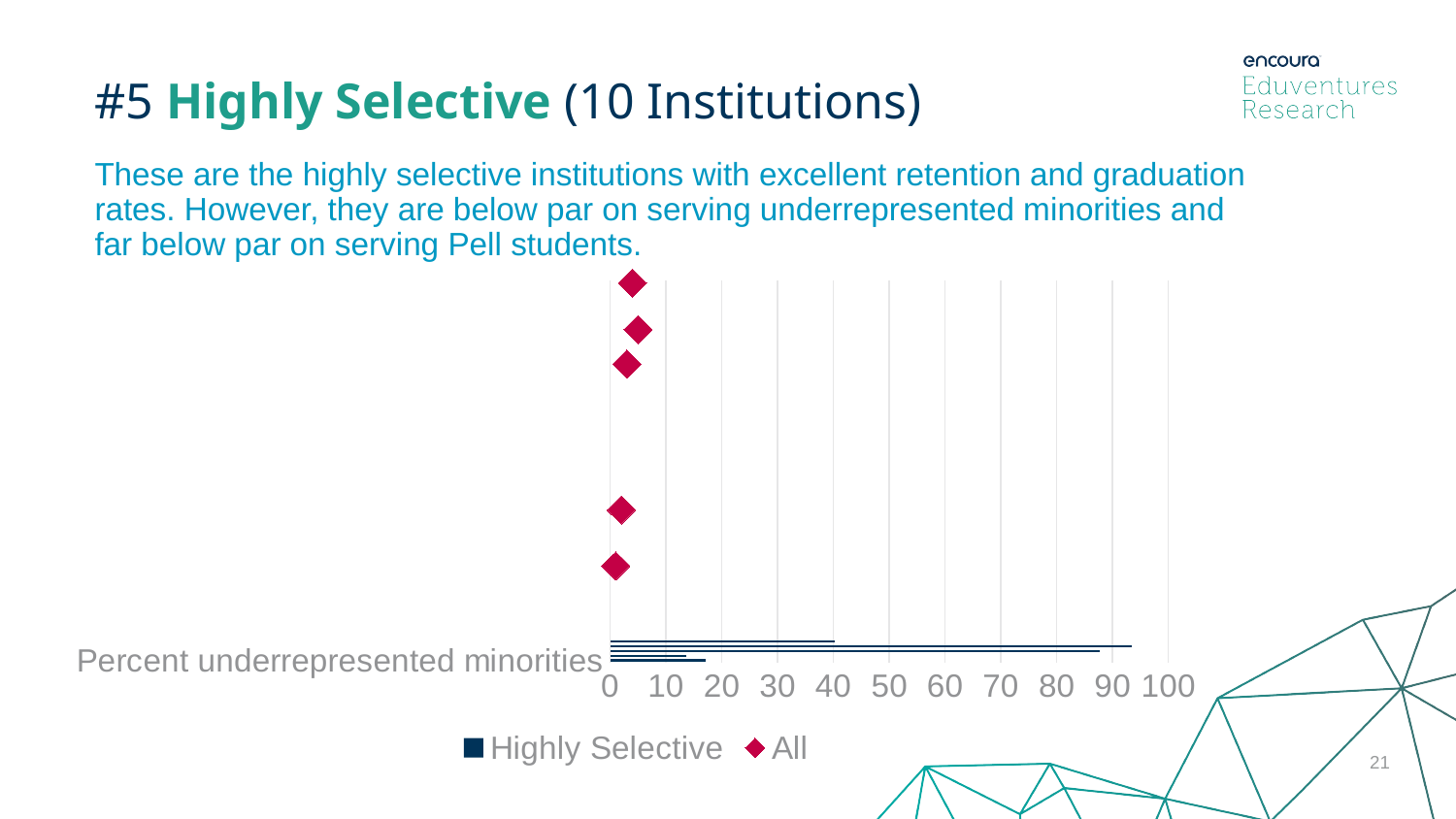
What are the two series named in the chart legend? Highly Selective and All What is the highest value labelled on the chart's horizontal axis? 100 Are the diamond markers for the All series greater or less than 20 on the horizontal axis? less How many series does the chart legend list? 2 What kind of chart is shown on the slide? Bar chart Are the diamond markers for the All series greater or less than 50 on the horizontal axis? less